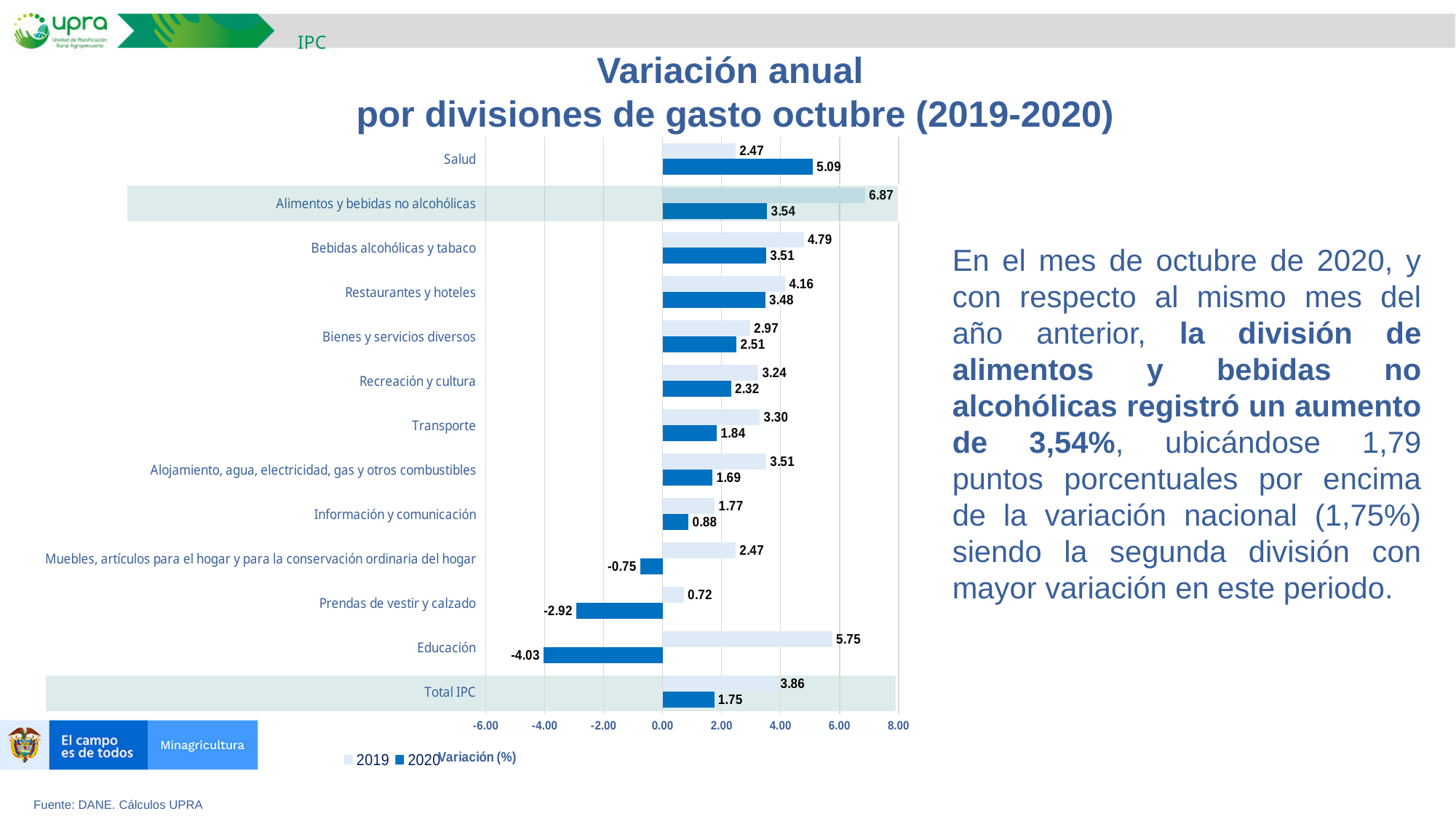
Which category has the highest 2020 value? Salud Which is larger for Transporte, the 2019 value or the 2020 value? 2019 How many series does the legend list? 2 What is the 2020 value for Alimentos y bebidas no alcohólicas? 3.54 What is the difference between the 2019 and 2020 values for Alimentos y bebidas no alcohólicas? 3.33 Which category has the lowest 2020 value? Educación What is the 2020 value for Total IPC? 1.75 What are the two legend entries of the chart? 2019 and 2020 What is the 2019 value for Educación? 5.75 Which category has the highest 2019 value? Alimentos y bebidas no alcohólicas What type of chart is shown on the slide? bar chart How many categories are plotted on the chart? 13